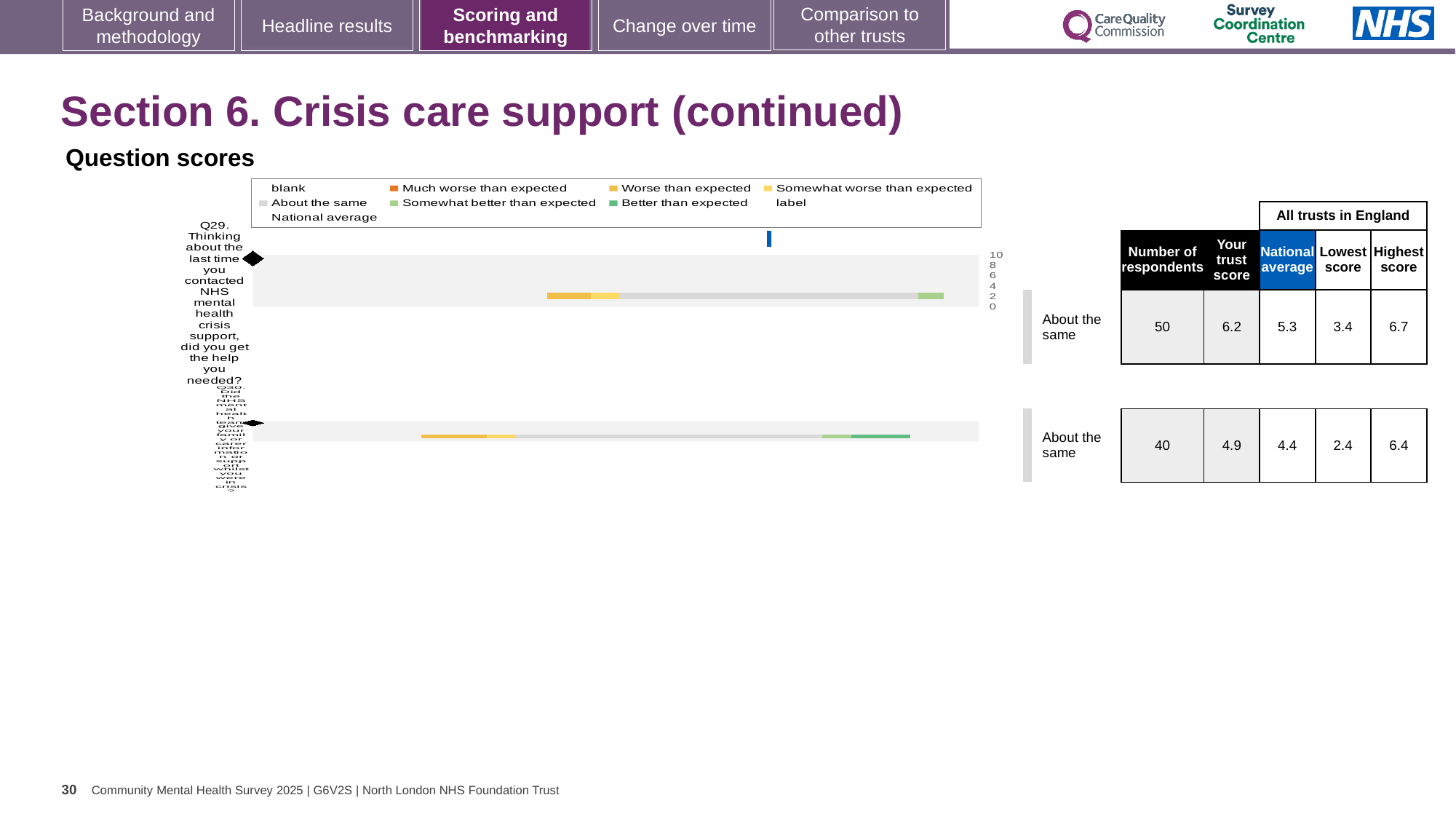
What is the lowest score among all trusts in England for Q29? 3.4 What is the trust score for Q29 (did you get the help you needed from NHS mental health crisis support)? 6.2 How many respondents answered Q29? 50 How many questions (categories) are plotted in the question scores chart? 2 Which benchmark category is shown for both Q29 and Q30? About the same Which question has the higher trust score, Q29 or Q30? Q29 What kind of chart is used to show the question scores on this slide? bar chart What is the highest score among all trusts in England for Q30? 6.4 What is the difference between the trust score and the national average for Q29? 0.9 What does the legend label the blue marker in the question scores chart? National average What is the difference between the highest and lowest scores across all trusts in England for Q30? 4.0 What is the national average for Q30 (did the NHS mental health team give your family or carer information or support whilst you were in crisis)? 4.4